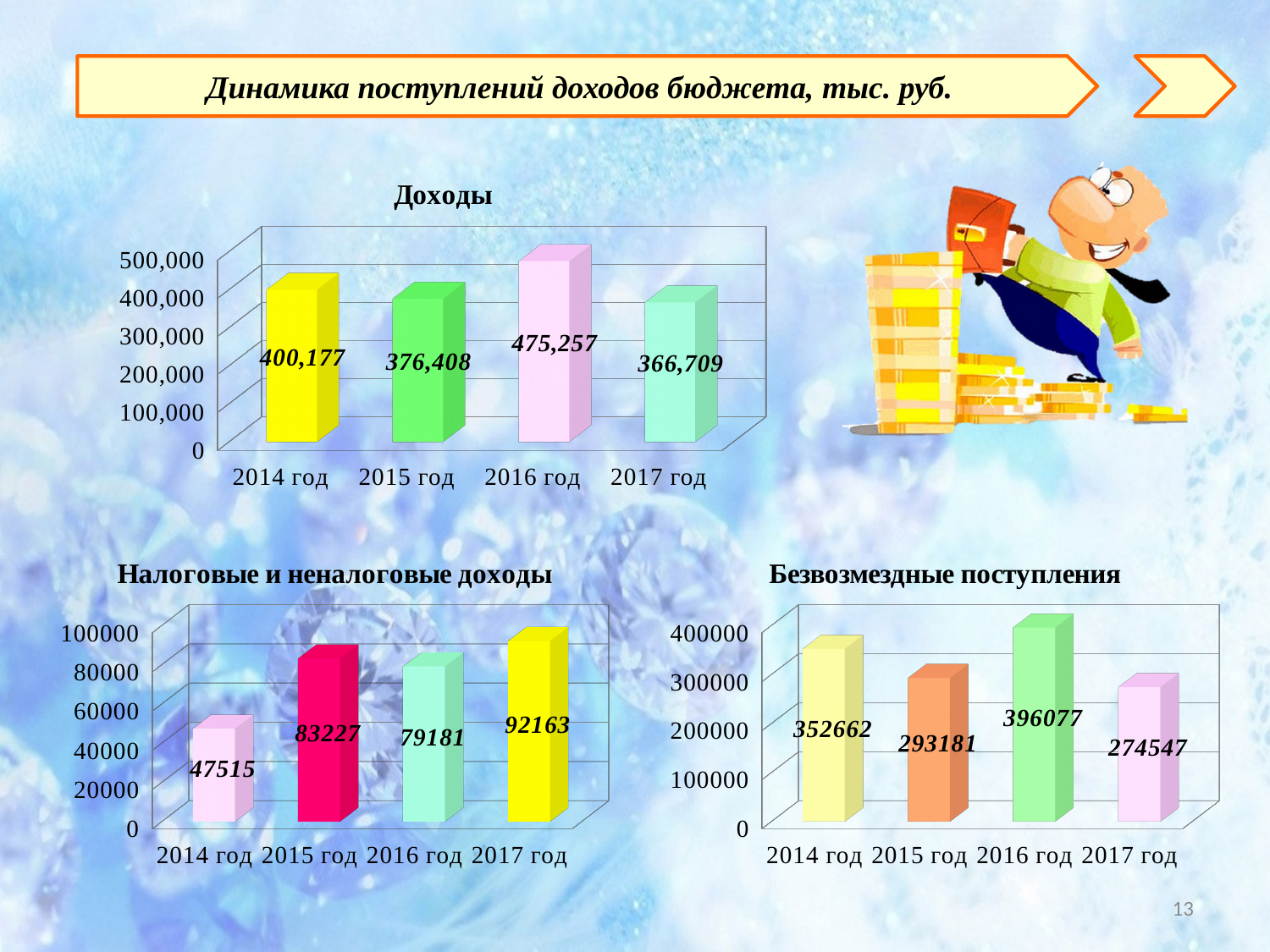
In the "Безвозмездные поступления" chart, which year has the highest value? 2016 год How many years are shown in the "Доходы" chart? 4 In the "Безвозмездные поступления" chart, what is the difference between the values for 2016 год and 2017 год? 121530 In the "Доходы" chart, what is the difference between the values for 2016 год and 2014 год? 75,080 In the "Налоговые и неналоговые доходы" chart, which is larger, the value for 2015 год or 2016 год? 2015 год How many charts are on the slide? 3 In the "Налоговые и неналоговые доходы" chart, which year has the highest value? 2017 год In the "Налоговые и неналоговые доходы" chart, what is the value for 2014 год? 47515 In the "Безвозмездные поступления" chart, what is the value for 2015 год? 293181 In the "Доходы" chart, which year has the lowest value? 2017 год What kind of chart is the "Безвозмездные поступления" chart? Bar chart In the "Доходы" chart, what is the value for 2016 год? 475,257